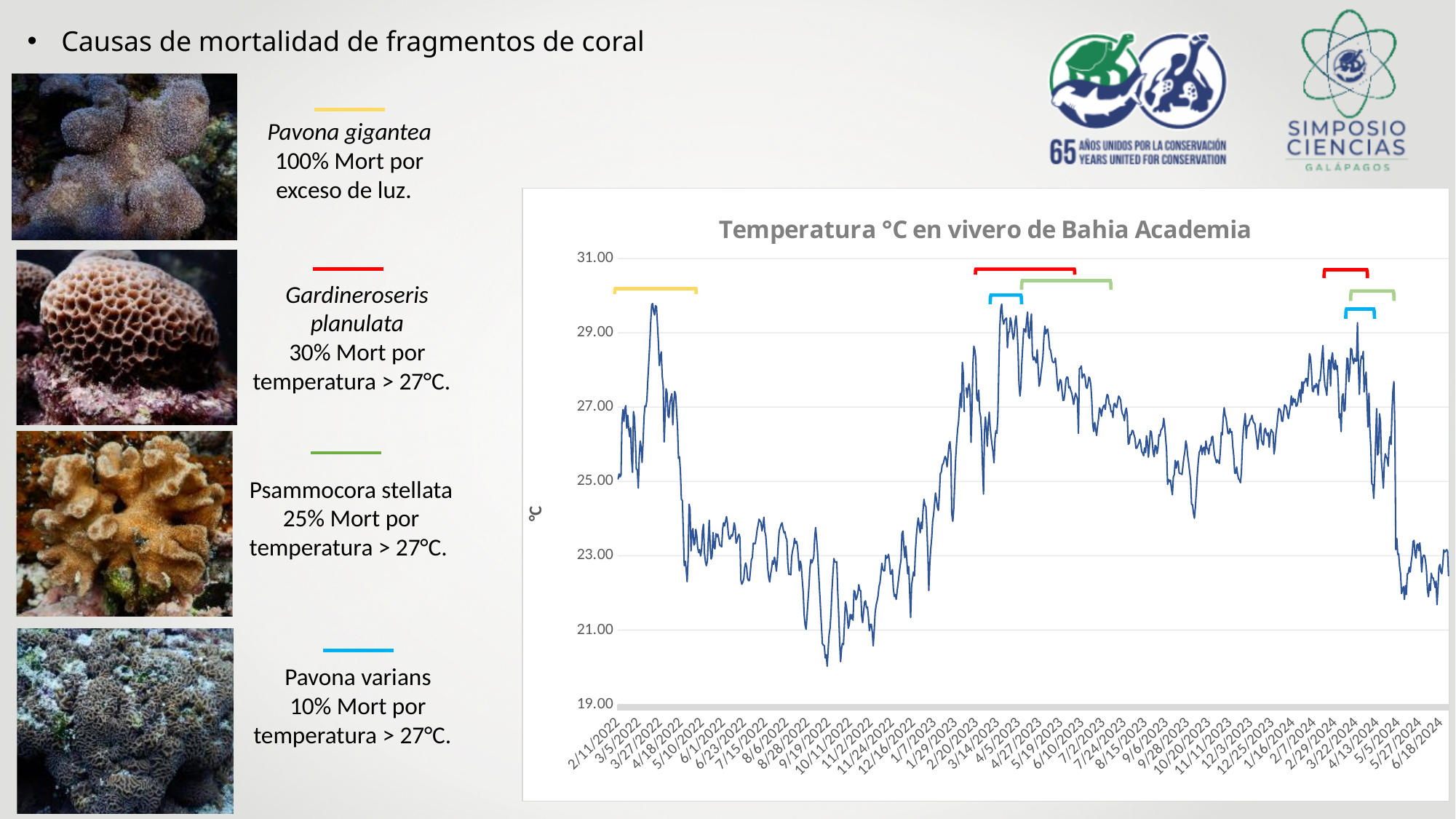
Is the peak temperature value near 4/5/2023 greater or less than 29.00? greater What kind of chart is shown on the slide? line chart How many data series are plotted on the chart? 1 Do the temperature values generally rise or fall between 3/27/2022 and 10/11/2022? fall What label is shown on the vertical axis of the chart? °C Is the peak temperature value near 3/27/2022 greater or less than 29.00? greater Is the lowest temperature value on the chart greater or less than 21.00? less Do the temperature values generally rise or fall between 10/11/2022 and 4/5/2023? rise What is the title of the chart? Temperatura °C en vivero de Bahia Academia